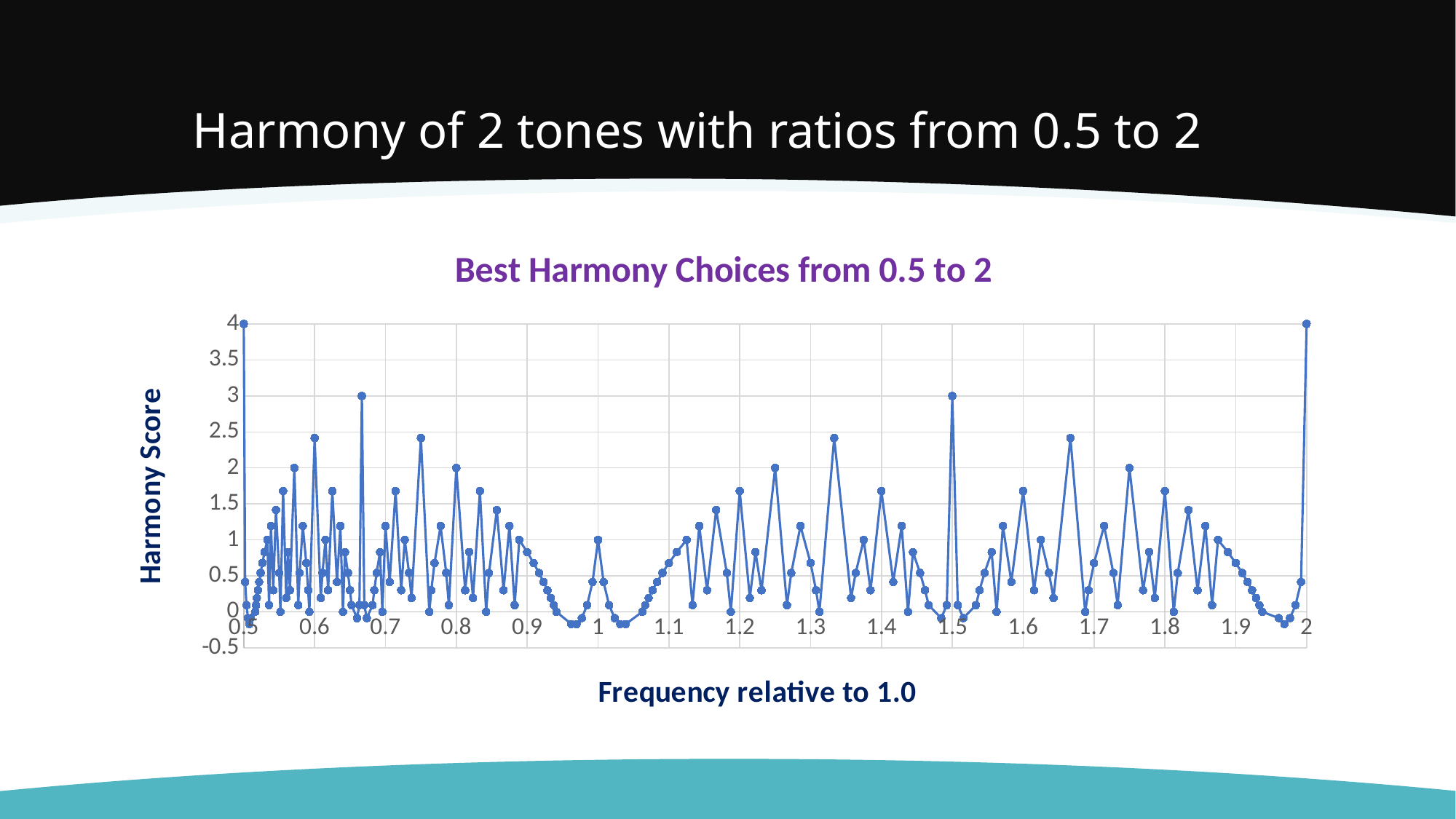
Between frequency ratios of 1.05 and 1.1, do the harmony scores rise or fall? rise What is the harmony score at a frequency ratio of 1.5? 3 What is the harmony score at a frequency ratio of 1? 1 Is the harmony score at a frequency ratio of 1.5 greater or less than 2? greater What kind of chart is shown on the slide? line chart Is the harmony score at a frequency ratio of 1 greater or less than 2? less What is the harmony score at a frequency ratio of 2? 4 What is the label of the vertical axis? Harmony Score What is the title of the chart? Best Harmony Choices from 0.5 to 2 What is the highest harmony score plotted on the chart? 4 Which has the larger harmony score: a frequency ratio of 1.5 or a frequency ratio of 1? 1.5 What is the harmony score at a frequency ratio of 0.5? 4